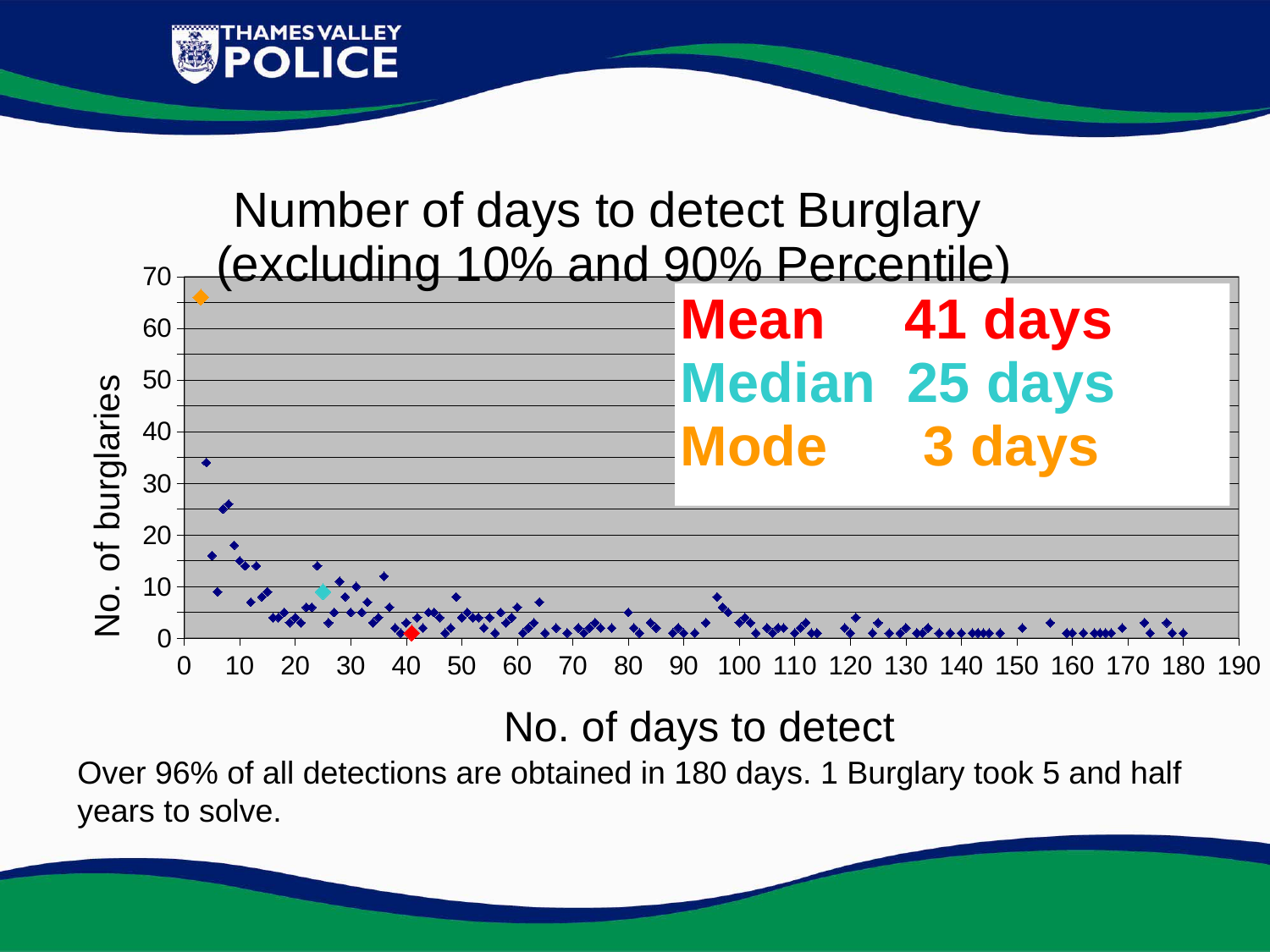
Overall, does the number of burglaries rise or fall as the number of days to detect increases? Fall What is the title of the chart? Number of days to detect Burglary (excluding 10% and 90% Percentile) According to the annotation on the chart, what is the median number of days to detect a burglary? 25 days What is the label of the vertical axis of the chart? No. of burglaries Are the numbers of burglaries for detection times beyond 100 days greater or less than 10? less Is the number of burglaries for the red point at about 41 days greater or less than 10? less Which is larger: the number of burglaries at the orange point near 3 days or at the cyan point near 25 days? The orange point near 3 days According to the annotation on the chart, what is the mean number of days to detect a burglary? 41 days According to the annotation on the chart, what is the mode number of days to detect a burglary? 3 days What is the highest value shown on the horizontal axis of the chart? 190 What kind of chart is shown on the slide? Scatter chart Is the number of burglaries at the highest point on the chart (the orange point near 3 days) greater or less than 60? greater